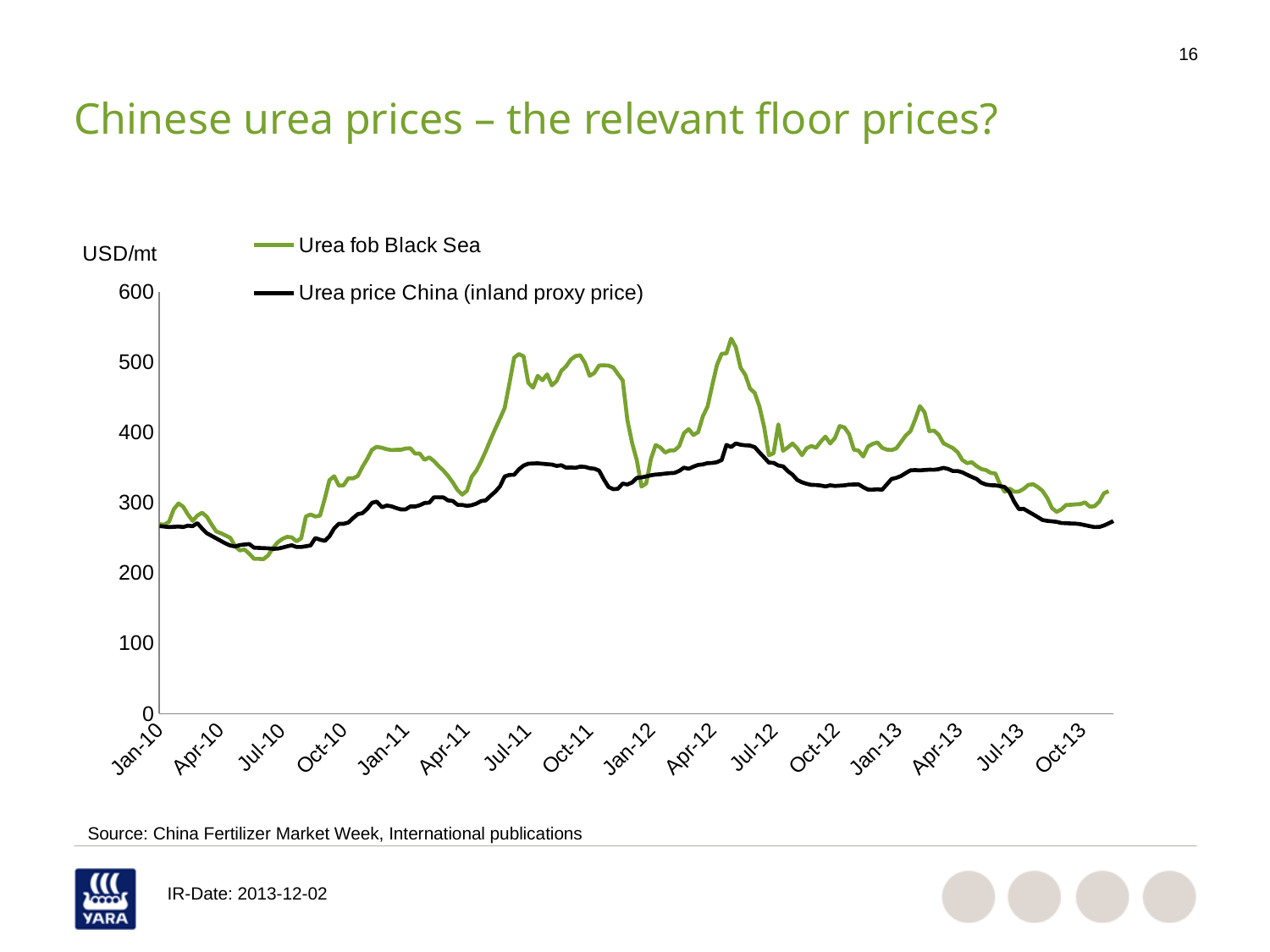
What kind of chart is shown on the slide? Line chart How many date labels are shown along the x axis? 16 Is the highest value reached by the Urea fob Black Sea series greater or less than 500? greater What unit is shown on the y axis of the chart? USD/mt Is the highest value reached by the Urea price China (inland proxy price) series greater or less than 400? less Is the Urea fob Black Sea value around Jul-11 greater or less than 400? greater How many series does the legend list? 2 Around Jul-11, which series has the higher value, Urea fob Black Sea or Urea price China (inland proxy price)? Urea fob Black Sea Which series is drawn in green? Urea fob Black Sea Around Oct-13, which series has the higher value, Urea fob Black Sea or Urea price China (inland proxy price)? Urea fob Black Sea Between Jan-10 and Jul-10, does the Urea fob Black Sea series rise or fall overall? fall